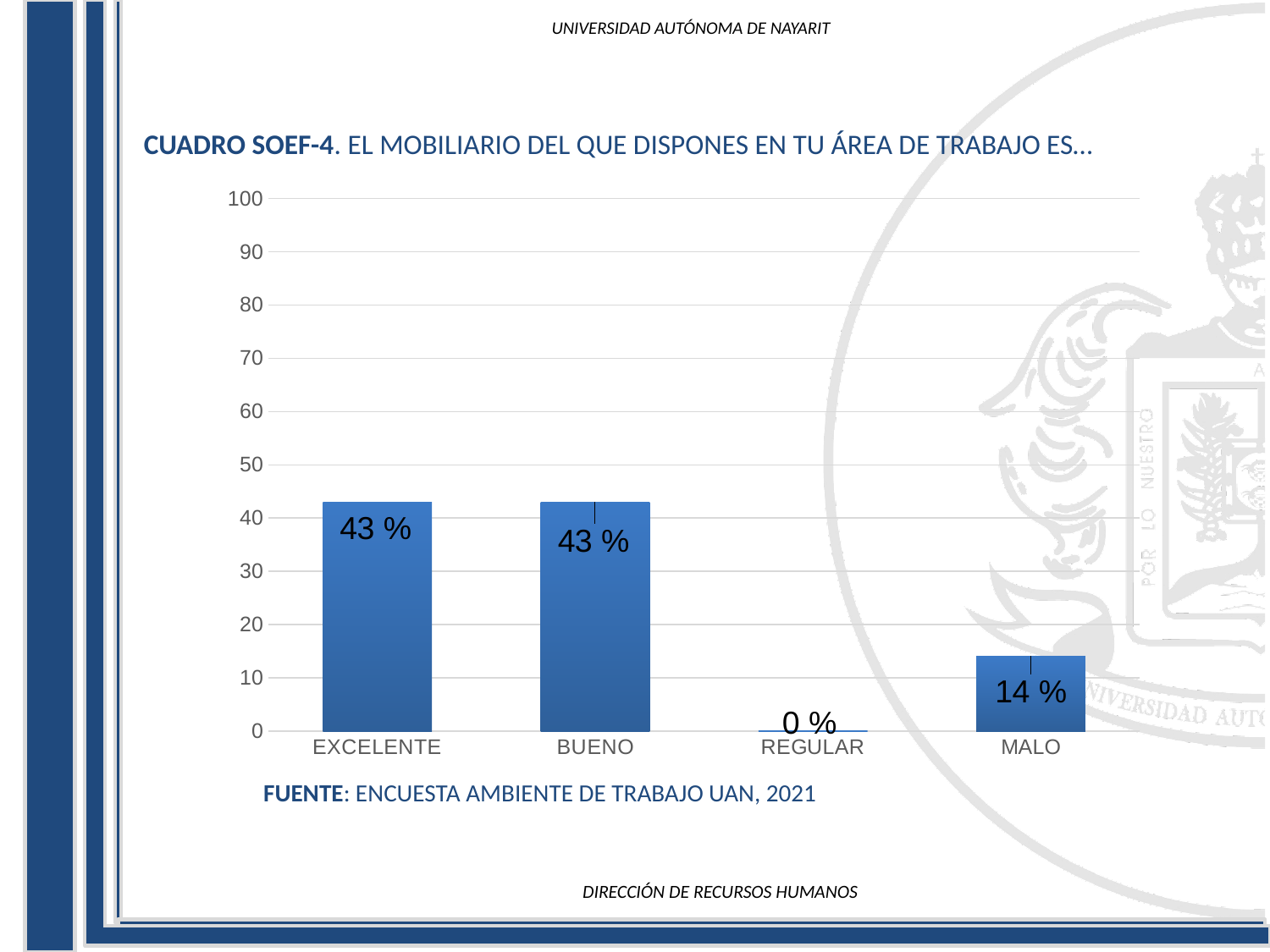
What is the source cited below the chart? ENCUESTA AMBIENTE DE TRABAJO UAN, 2021 How many categories are shown on the x axis? 4 What is the value for MALO? 14 % Which is larger, the value for MALO or the value for REGULAR? MALO What is the difference between the values for EXCELENTE and MALO? 29 % Which category has the lowest value? REGULAR What is the value for EXCELENTE? 43 % Is the value for BUENO greater or less than 50? less What is the value for BUENO? 43 % What is the value for REGULAR? 0 % What is the highest value shown on the y axis? 100 What kind of chart is shown on the slide? bar chart